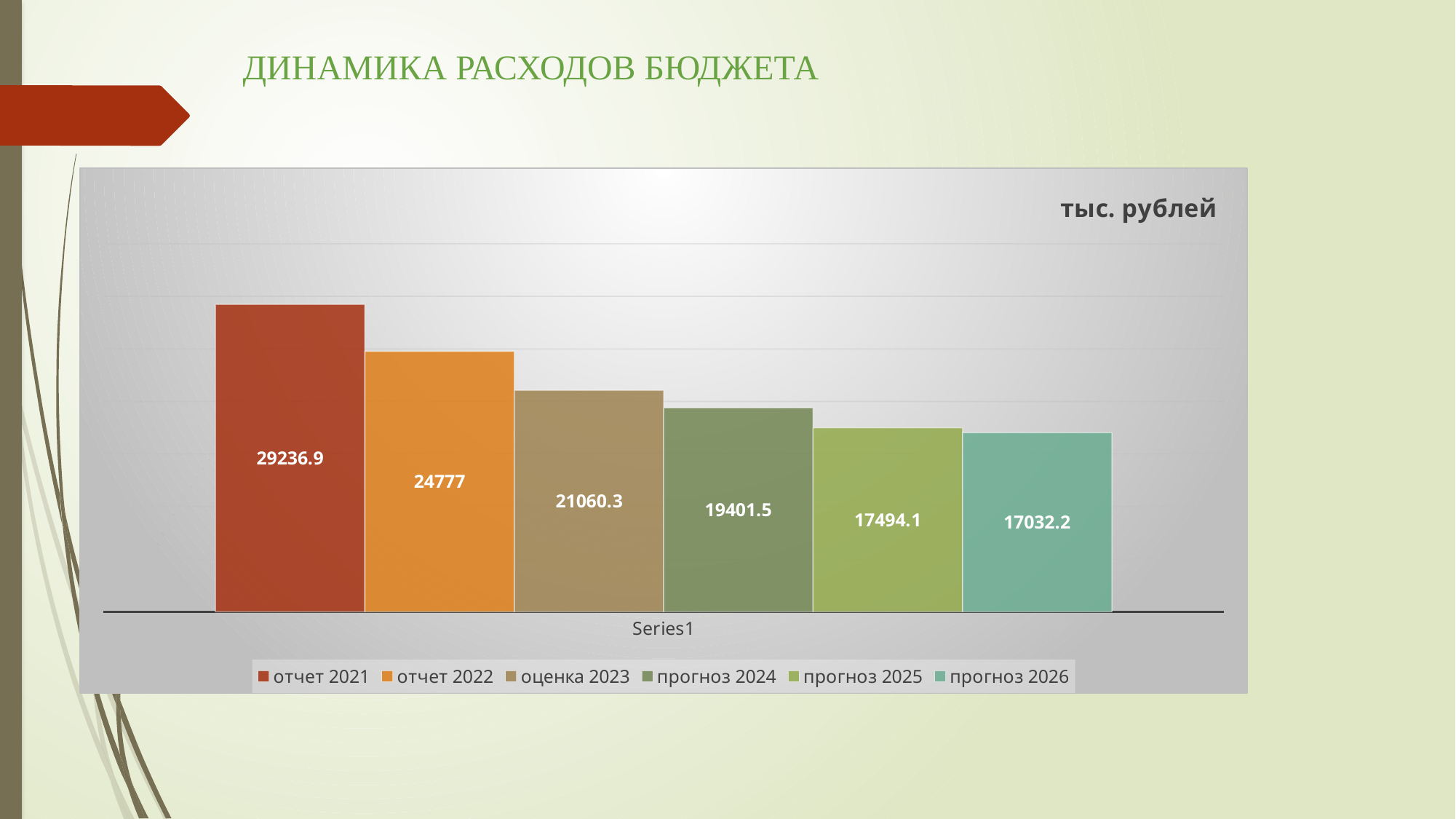
What is the value for оценка 2023? 21060.3 How many series does the legend list? 6 What is the value for отчет 2021? 29236.9 Do the values rise or fall from отчет 2021 to прогноз 2026? fall Which series has the highest value? отчет 2021 What is the value for прогноз 2024? 19401.5 What unit label is shown in the top right corner of the chart? тыс. рублей What kind of chart is shown on the slide? bar chart What is the difference between the values for отчет 2021 and отчет 2022? 4459.9 Which series has the lowest value? прогноз 2026 Which is larger, the value for отчет 2022 or the value for оценка 2023? отчет 2022 What is the difference between the values for прогноз 2025 and прогноз 2026? 461.9